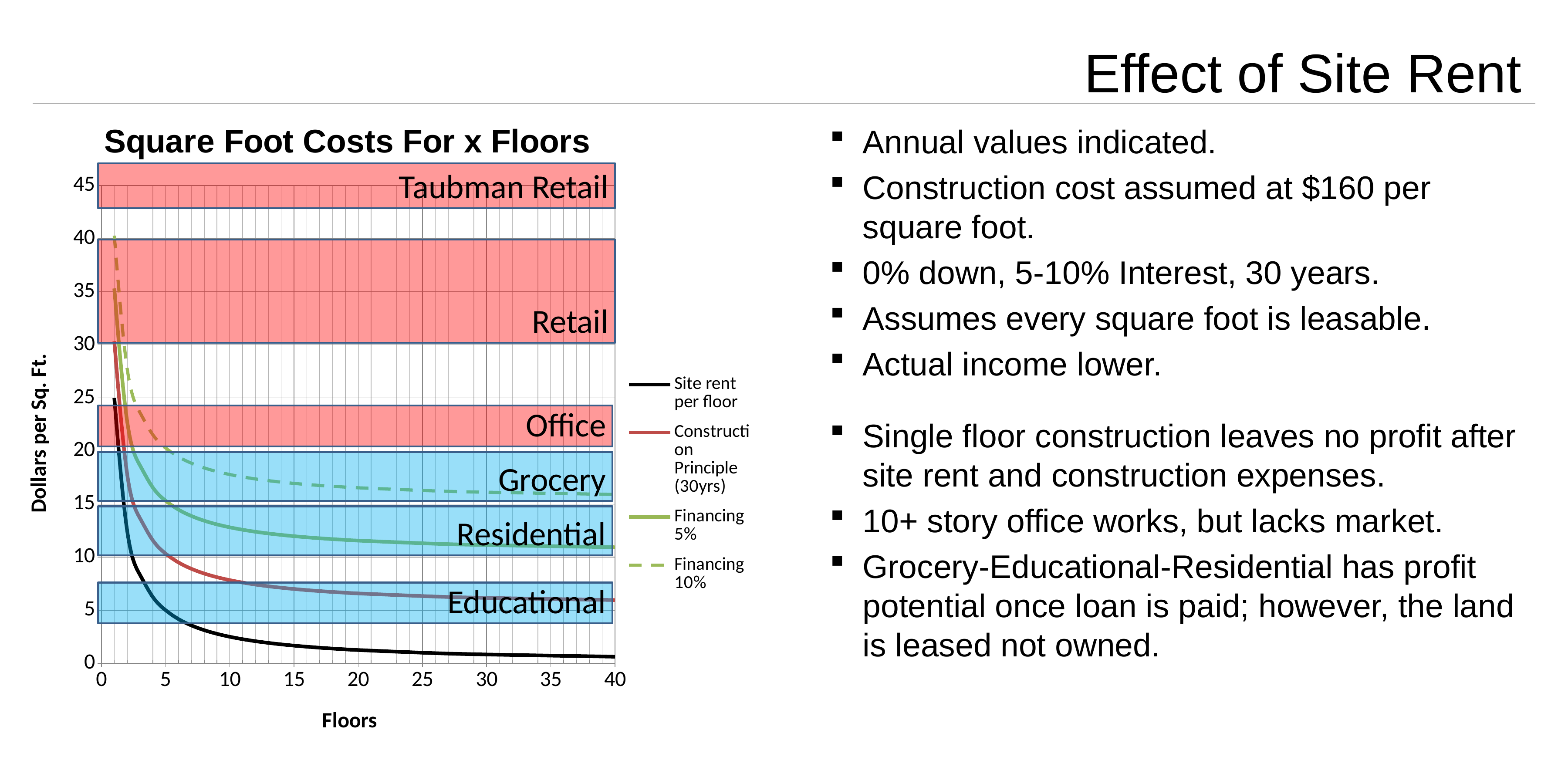
At 40 floors, which is larger: Financing 10% or Financing 5%? Financing 10% Is the value of Financing 10% at 40 floors greater or less than 15? greater Do the values of the Site rent per floor series rise or fall as the number of floors increases? Fall Is the value of Financing 5% at 40 floors greater or less than 10? greater Which series has the lowest value at 40 floors? Site rent per floor Is the value of Construction Principle (30yrs) at 40 floors greater or less than 10? less Do the values of the Financing 10% series rise or fall as the number of floors increases? Fall What is the label of the y axis of the chart? Dollars per Sq. Ft. How many series does the legend of the chart list? 4 What is the title of the chart? Square Foot Costs For x Floors What kind of chart is shown on the slide? Line chart